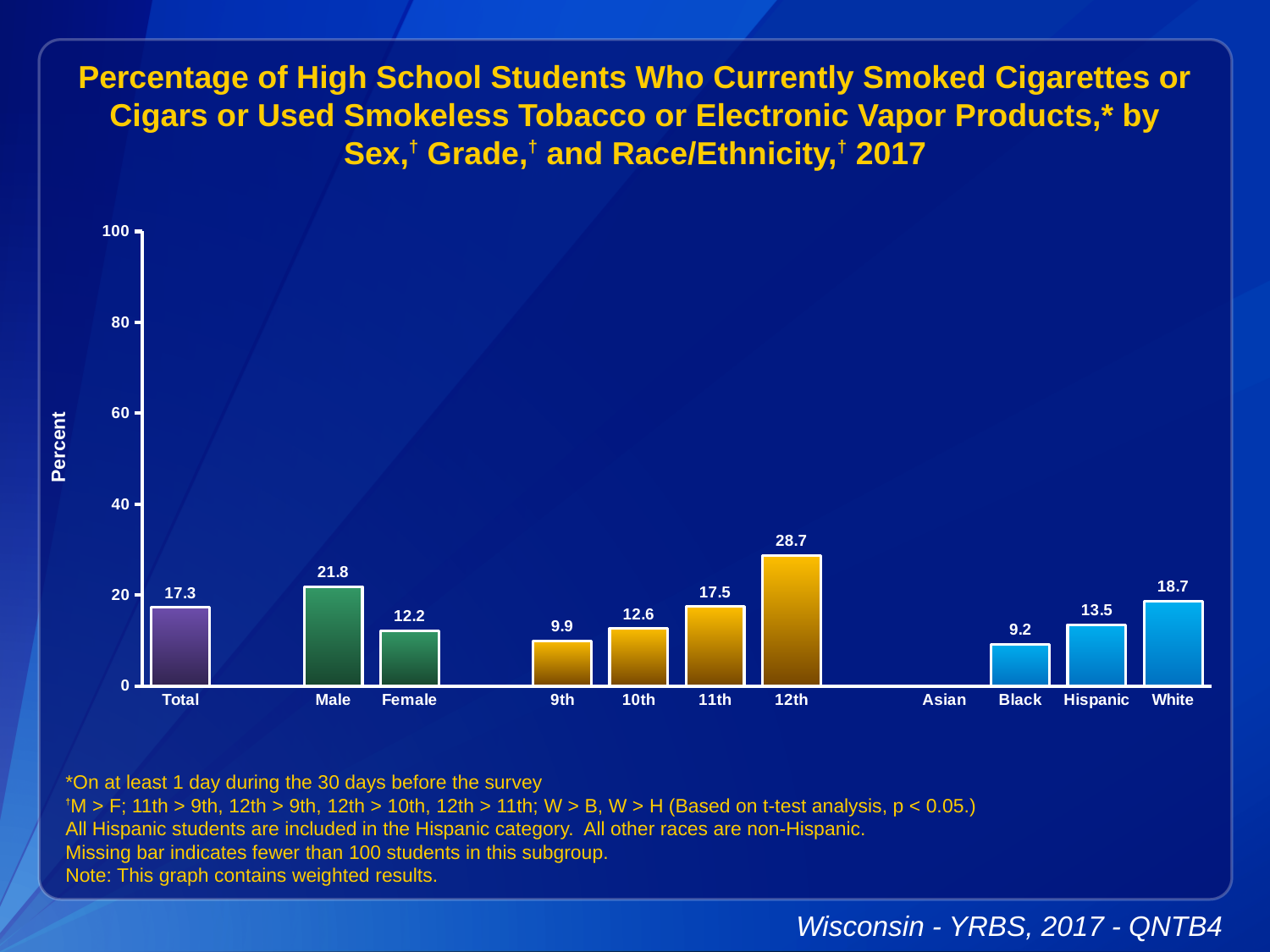
What is the value for Total? 17.3 What is the value for 12th grade? 28.7 Which category has the highest value? 12th What is the value for Black? 9.2 Is the value for 12th grade greater or less than 20? greater Do the values rise or fall from 9th grade to 12th grade? Rise Which category with a bar has the lowest value? Black How many categories have a bar plotted? 10 Which is larger, the value for White or the value for Hispanic? White What is the value for Male? 21.8 What is the difference between the Male and Female values? 9.6 What kind of chart is shown? Bar chart